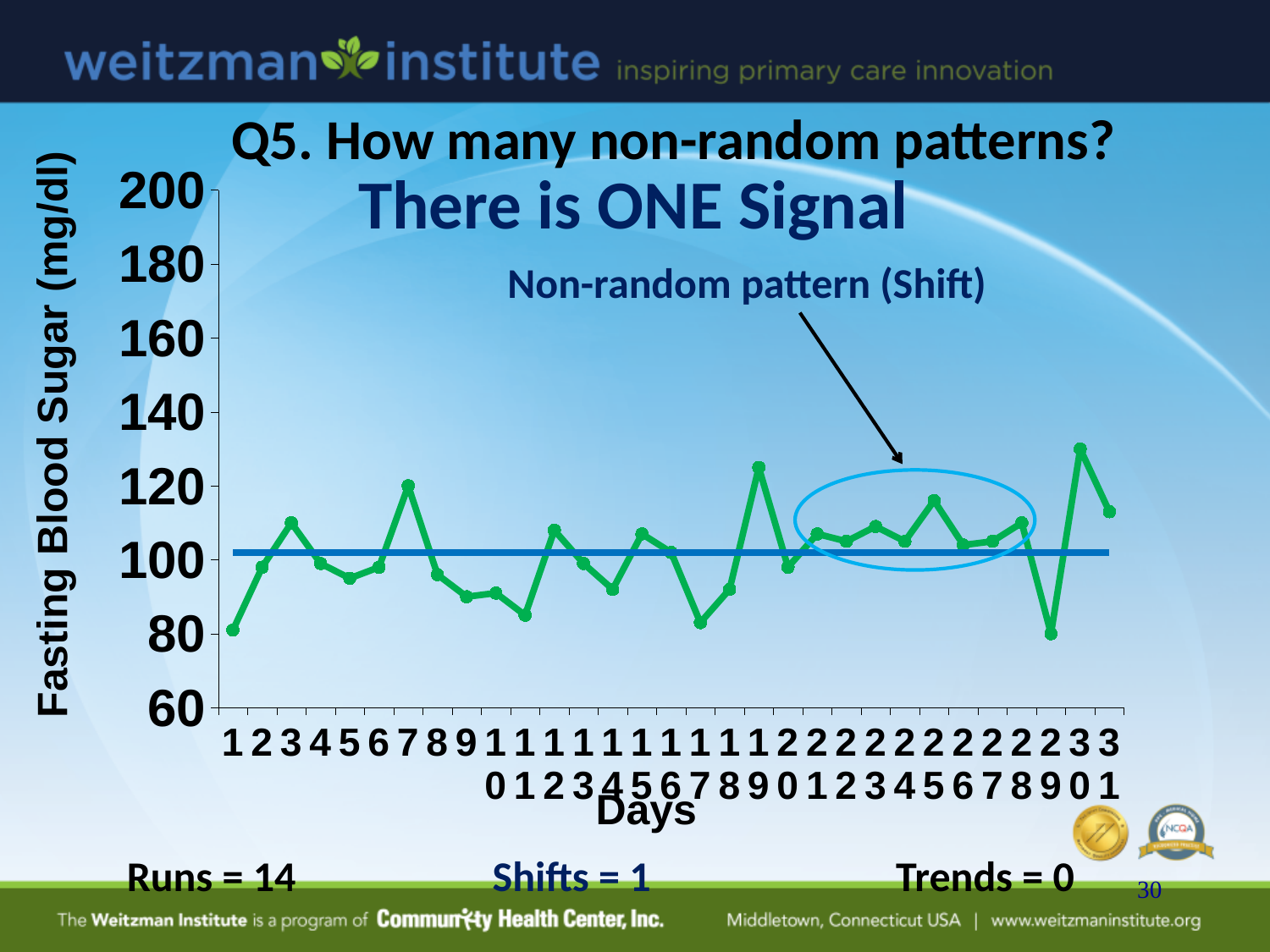
Is the fasting blood sugar value for day 7 greater or less than 100? greater Is the fasting blood sugar value for day 29 greater or less than 100? less Is the fasting blood sugar value for day 30 greater or less than 120? greater Which day has the larger fasting blood sugar value, day 19 or day 20? day 19 What kind of chart is shown on the slide? line chart How many days (data points) are plotted on the chart? 31 Which day has the larger fasting blood sugar value, day 7 or day 8? day 7 What is the label of the y-axis? Fasting Blood Sugar (mg/dl) What does the annotation pointing to the circled points on the chart say? Non-random pattern (Shift)